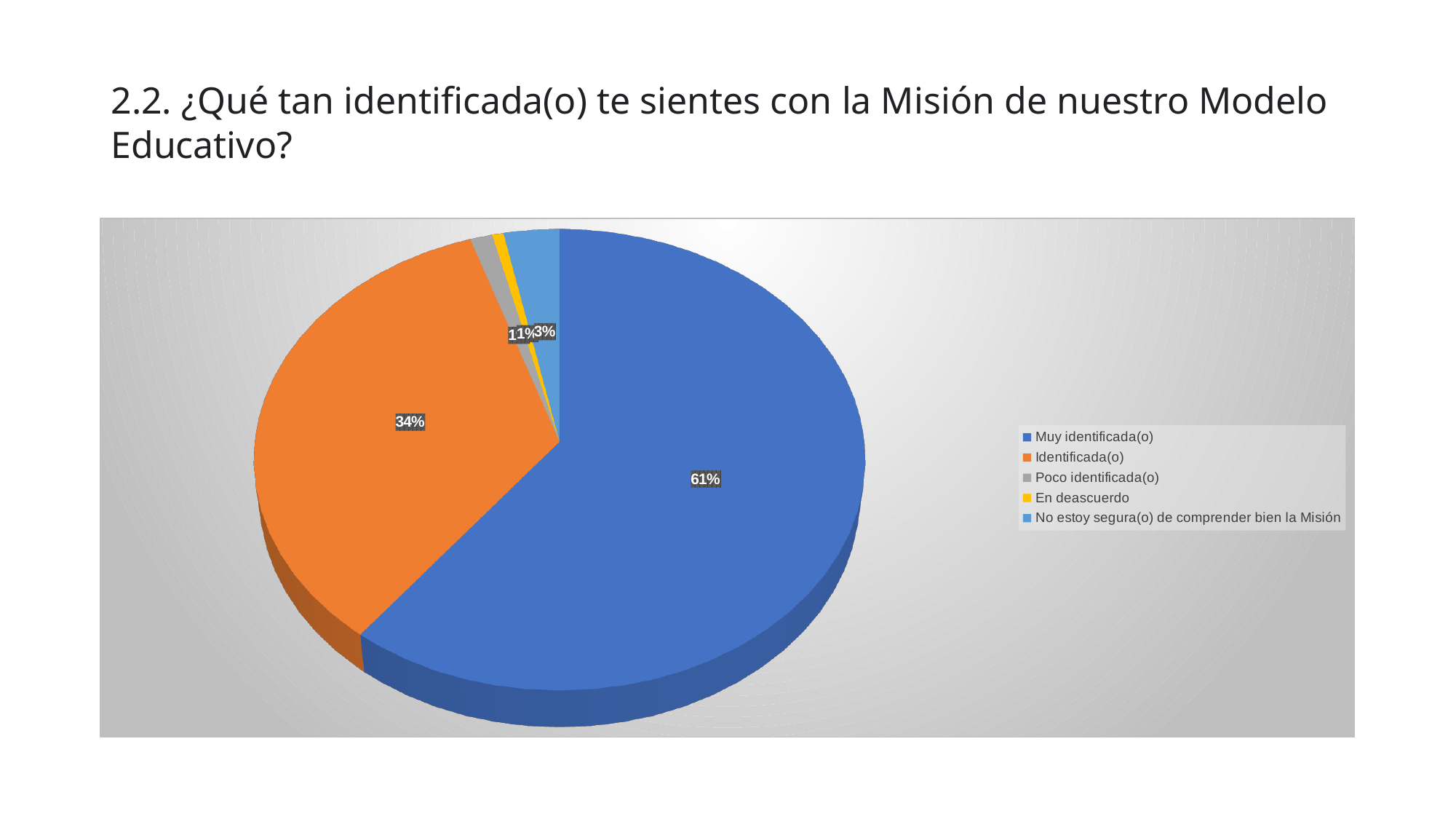
Which is larger, the share for "Identificada(o)" or the share for "Muy identificada(o)"? Muy identificada(o) What colour is the slice for "Identificada(o)"? Orange Which response category has the largest share of the pie? Muy identificada(o) What percentage of respondents answered "Identificada(o)"? 34% How many response categories does the pie chart show? 5 What kind of chart is shown on the slide? Pie chart What percentage of respondents answered "Muy identificada(o)"? 61% Which legend entry is shown in yellow? En deascuerdo What percentage of respondents answered "No estoy segura(o) de comprender bien la Misión"? 3% Which is larger, the share for "No estoy segura(o) de comprender bien la Misión" or the share for "Identificada(o)"? Identificada(o) What is the difference in percentage points between "Muy identificada(o)" and "Identificada(o)"? 27